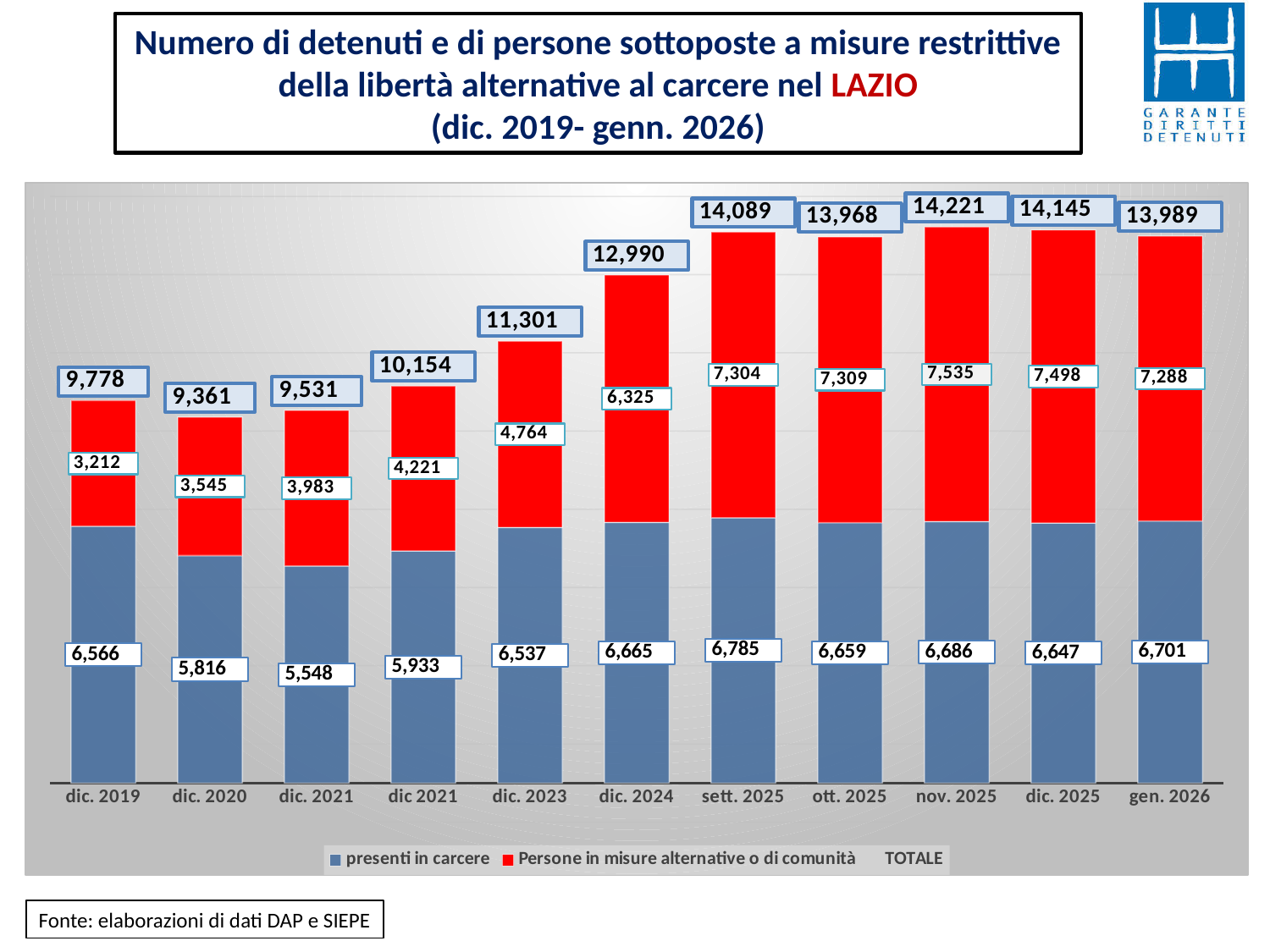
How many time periods (bars) are shown on the x axis? 11 What kind of chart is shown on the slide? stacked bar chart What is the total of the stacked bar for dic. 2023? 11,301 Which colour represents 'presenti in carcere' in the chart? blue What is the TOTALE value for nov. 2025? 14,221 How many entries does the legend list? 3 Which period has the highest TOTALE value? nov. 2025 Which period has the lowest TOTALE value? dic. 2020 What is the value of 'presenti in carcere' for dic. 2019? 6,566 Which is larger for sett. 2025: 'presenti in carcere' or 'Persone in misure alternative o di comunità'? Persone in misure alternative o di comunità What is the value of 'Persone in misure alternative o di comunità' for dic. 2024? 6,325 What is the difference between the TOTALE for gen. 2026 and the TOTALE for dic. 2019? 4,211